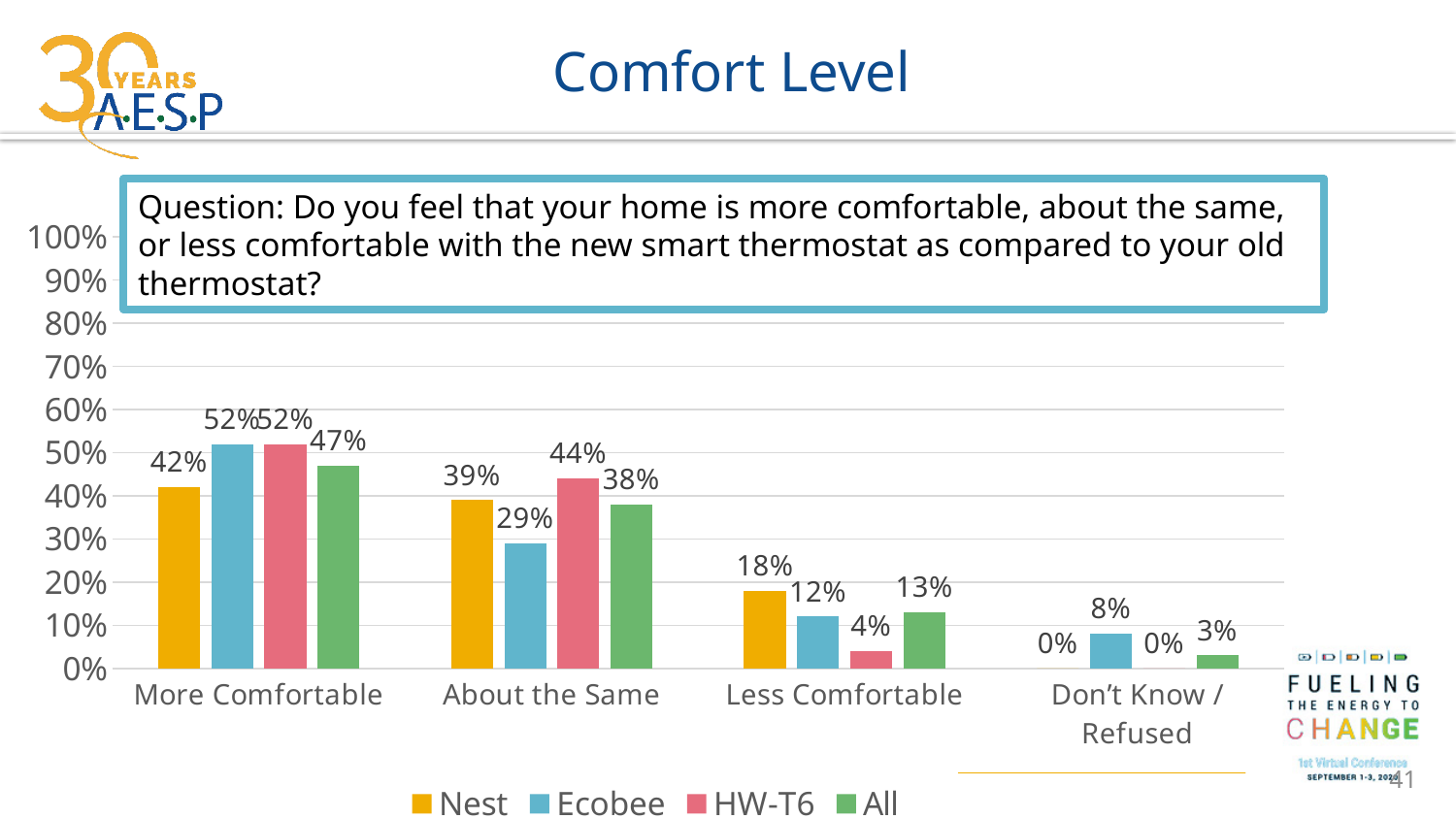
What is the value for All in the Don't Know / Refused category? 3% What kind of chart is shown on the slide? Bar chart How many series does the legend list? 4 How many categories are shown on the x axis? 4 Which series has the highest value in the About the Same category? HW-T6 What is the value for Ecobee in the About the Same category? 29% What is the difference between the Nest and Ecobee values in the About the Same category? 10% What is the title of the slide? Comfort Level What is the value for HW-T6 in the Less Comfortable category? 4% What percentage of Nest respondents said their home is More Comfortable? 42% Which series has the lowest value in the Less Comfortable category? HW-T6 Which is larger: the Nest value for Less Comfortable or the Ecobee value for Less Comfortable? Nest